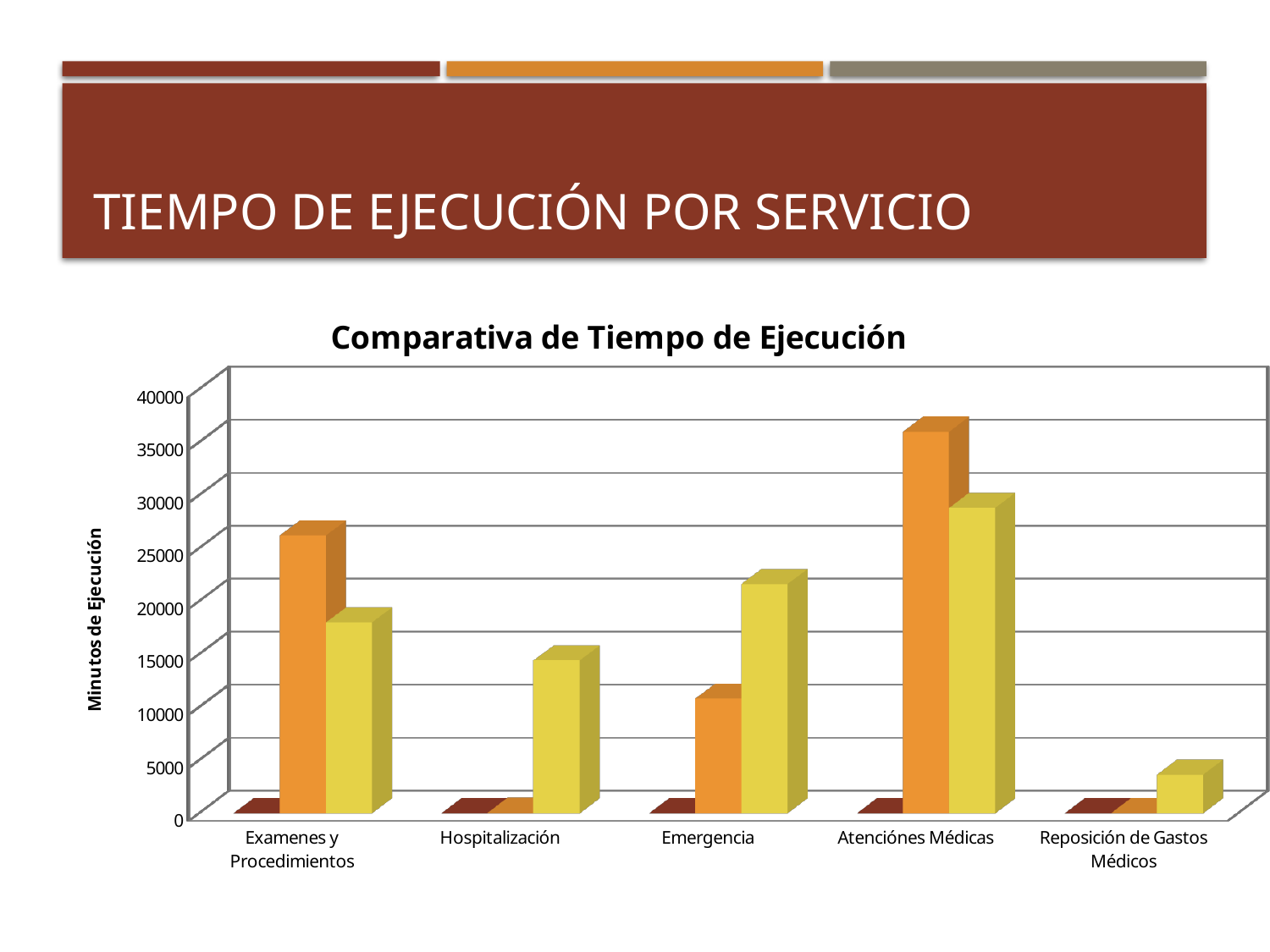
What kind of chart is shown on the slide? Bar chart For Emergencia, which is larger, the orange bar or the yellow bar? Yellow bar Is the value of the yellow bar for Hospitalización greater or less than 10000? greater Which category has the tallest orange bar? Atenciónes Médicas For Examenes y Procedimientos, which is larger, the orange bar or the yellow bar? Orange bar Which category has the shortest yellow bar? Reposición de Gastos Médicos What is the label on the vertical axis of the chart? Minutos de Ejecución Which category has the tallest yellow bar? Atenciónes Médicas Is the value of the orange bar for Atenciónes Médicas greater or less than 30000? greater How many service categories are shown along the x axis? 5 Is the value of the orange bar for Emergencia greater or less than 15000? less What is the title of the chart? Comparativa de Tiempo de Ejecución